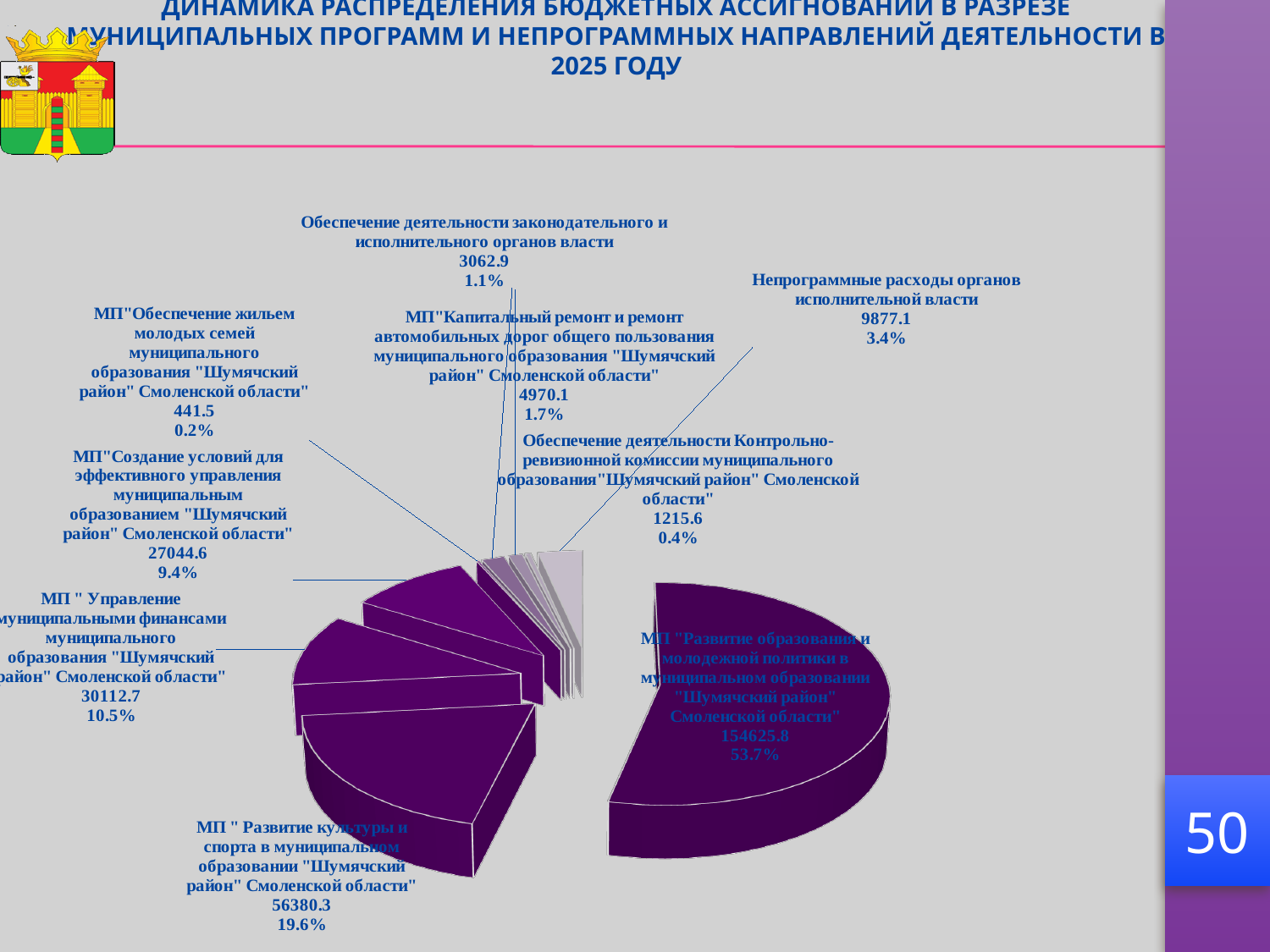
What share of the pie does Обеспечение деятельности Контрольно-ревизионной комиссии муниципального образования "Шумячский район" Смоленской области" represent? 0.4% How many slices does the pie chart have? 9 What is the difference between the values for Непрограммные расходы органов исполнительной власти and Обеспечение деятельности законодательного и исполнительного органов власти? 6814.2 What kind of chart is shown on the slide? Pie chart What is the value for МП "Создание условий для эффективного управления муниципальным образованием "Шумячский район" Смоленской области"? 27044.6 Which category has the largest slice of the pie? МП "Развитие образования и молодежной политики в муниципальном образовании "Шумячский район" Смоленской области" Which is larger: the value for Непрограммные расходы органов исполнительной власти or the value for МП "Капитальный ремонт и ремонт автомобильных дорог..."? Непрограммные расходы органов исполнительной власти What is the value for МП "Развитие образования и молодежной политики в муниципальном образовании "Шумячский район" Смоленской области"? 154625.8 What is the value for Непрограммные расходы органов исполнительной власти? 9877.1 What share of the pie does МП "Развитие культуры и спорта в муниципальном образовании "Шумячский район" Смоленской области" represent? 19.6% Which category has the smallest slice of the pie? МП "Обеспечение жильем молодых семей муниципального образования "Шумячский район" Смоленской области" What is the difference between the values for МП "Управление муниципальными финансами..." and МП "Создание условий для эффективного управления муниципальным образованием..."? 3068.1